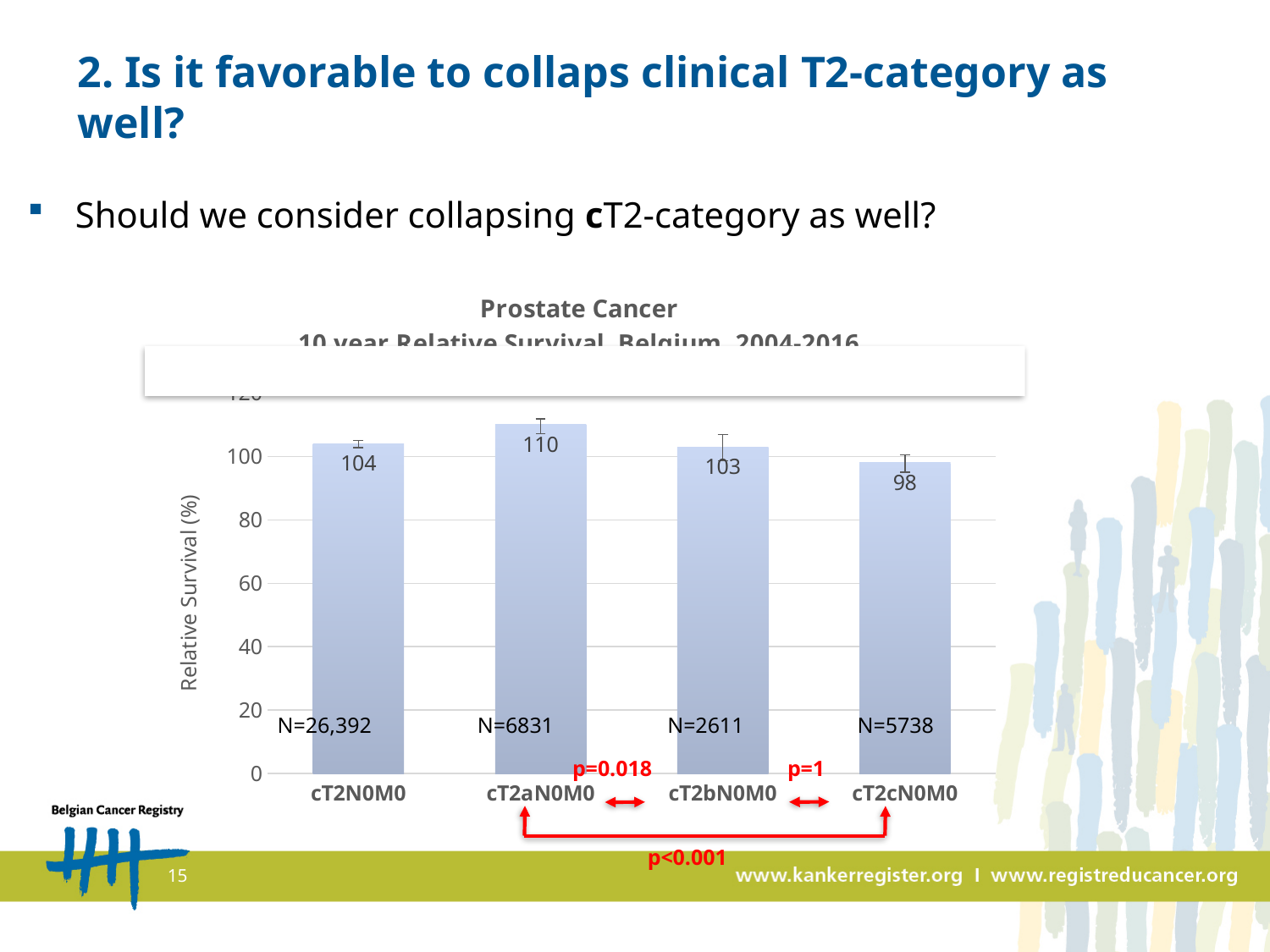
How many categories are shown on the x axis of the chart? 4 Which category has the highest relative survival value? cT2aN0M0 Is the value for cT2cN0M0 greater or less than 100? less What is the label of the y axis of the chart? Relative Survival (%) What kind of chart is shown on the slide? bar chart What is the difference between the relative survival values for cT2aN0M0 and cT2cN0M0? 12 Which has a larger relative survival value, cT2N0M0 or cT2bN0M0? cT2N0M0 What is the relative survival value shown for cT2cN0M0? 98 What is the relative survival value shown for cT2N0M0? 104 What is the N (number of patients) shown for the cT2N0M0 bar? N=26,392 Which category has the lowest relative survival value? cT2cN0M0 What is the relative survival value shown for cT2aN0M0? 110